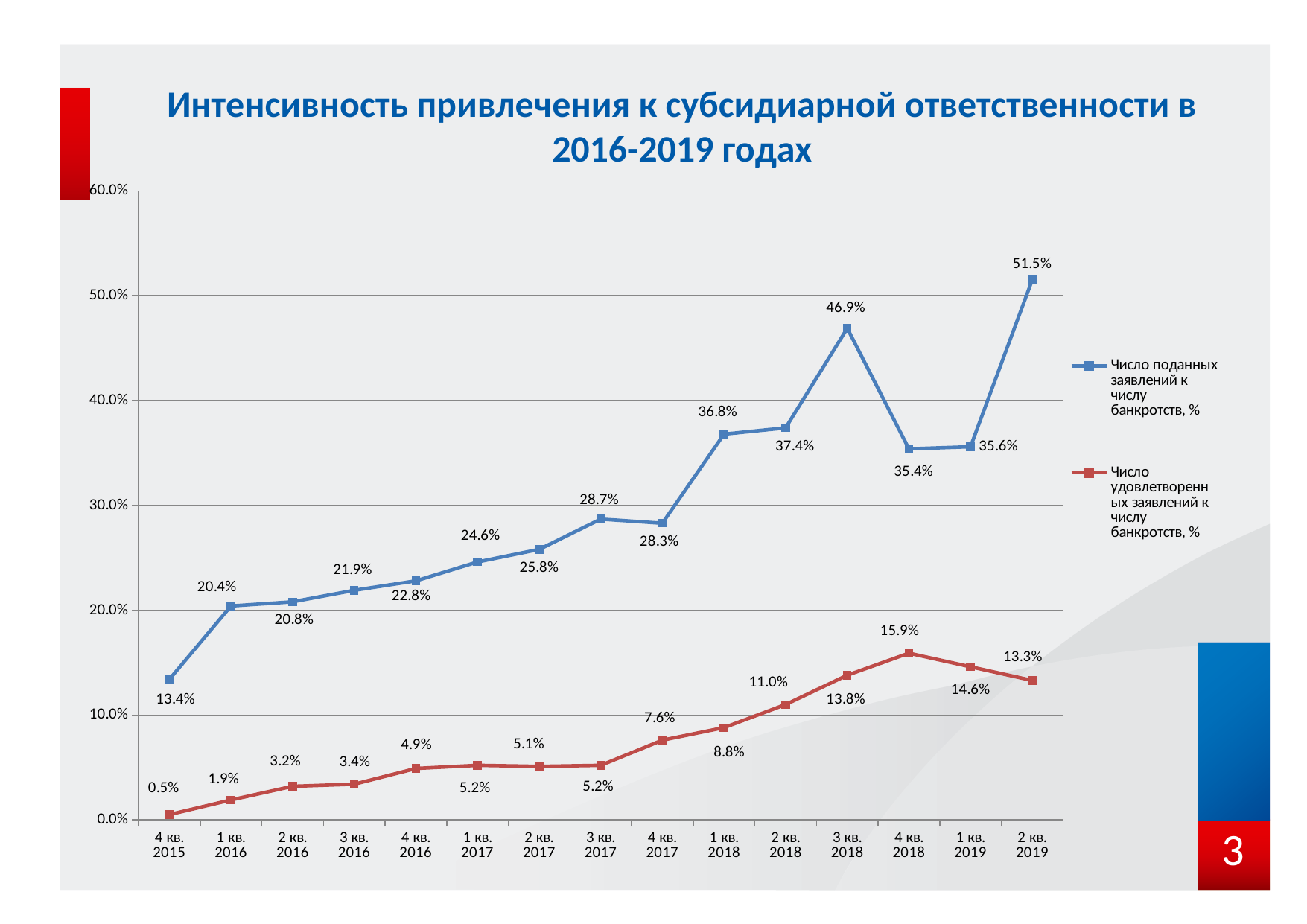
What is the title of the chart? Интенсивность привлечения к субсидиарной ответственности в 2016-2019 годах In which quarter is 'Число удовлетворенных заявлений к числу банкротств, %' lowest? 4 кв. 2015 What type of chart is shown on the slide? Line chart How many series does the legend list? 2 What is the value of 'Число удовлетворенных заявлений к числу банкротств, %' in 4 кв. 2018? 15.9% What is the value of 'Число поданных заявлений к числу банкротств, %' in 3 кв. 2018? 46.9% Which is larger for 'Число поданных заявлений к числу банкротств, %': 3 кв. 2018 or 4 кв. 2018? 3 кв. 2018 Is the value of 'Число поданных заявлений к числу банкротств, %' in 1 кв. 2018 greater or less than 30.0%? greater In which quarter does 'Число поданных заявлений к числу банкротств, %' reach its highest value? 2 кв. 2019 How many quarters are plotted along the x axis? 15 Does 'Число удовлетворенных заявлений к числу банкротств, %' generally rise or fall from 4 кв. 2015 to 4 кв. 2018? Rise What is the difference between the two series in 2 кв. 2019? 38.2%